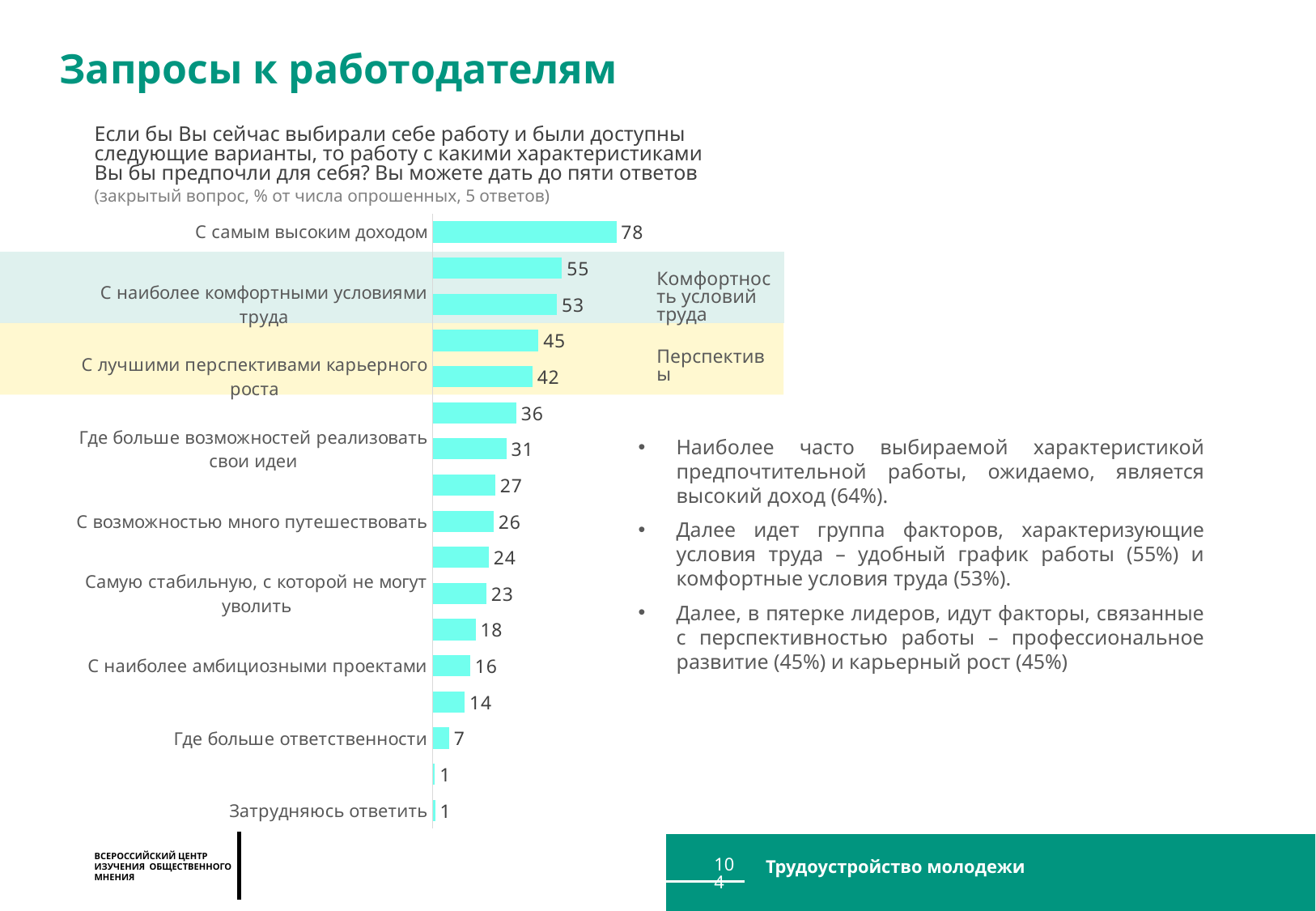
What is the value for "Где больше ответственности"? 7 Which is larger: the value for "С возможностью много путешествовать" or for "С наиболее амбициозными проектами"? С возможностью много путешествовать What kind of chart is shown on the slide? Bar chart What is the value for "С наиболее комфортными условиями труда"? 53 What is the value for "С возможностью много путешествовать"? 26 Which category has the highest value? С самым высоким доходом What is the value for "Затрудняюсь ответить"? 1 What is the difference between the values for "С самым высоким доходом" and "С наиболее комфортными условиями труда"? 25 What is the lowest value shown on the chart? 1 Do the bar values increase or decrease from the top of the chart to the bottom? Decrease What is the value for "С самым высоким доходом"? 78 How many bars are plotted on the chart? 17